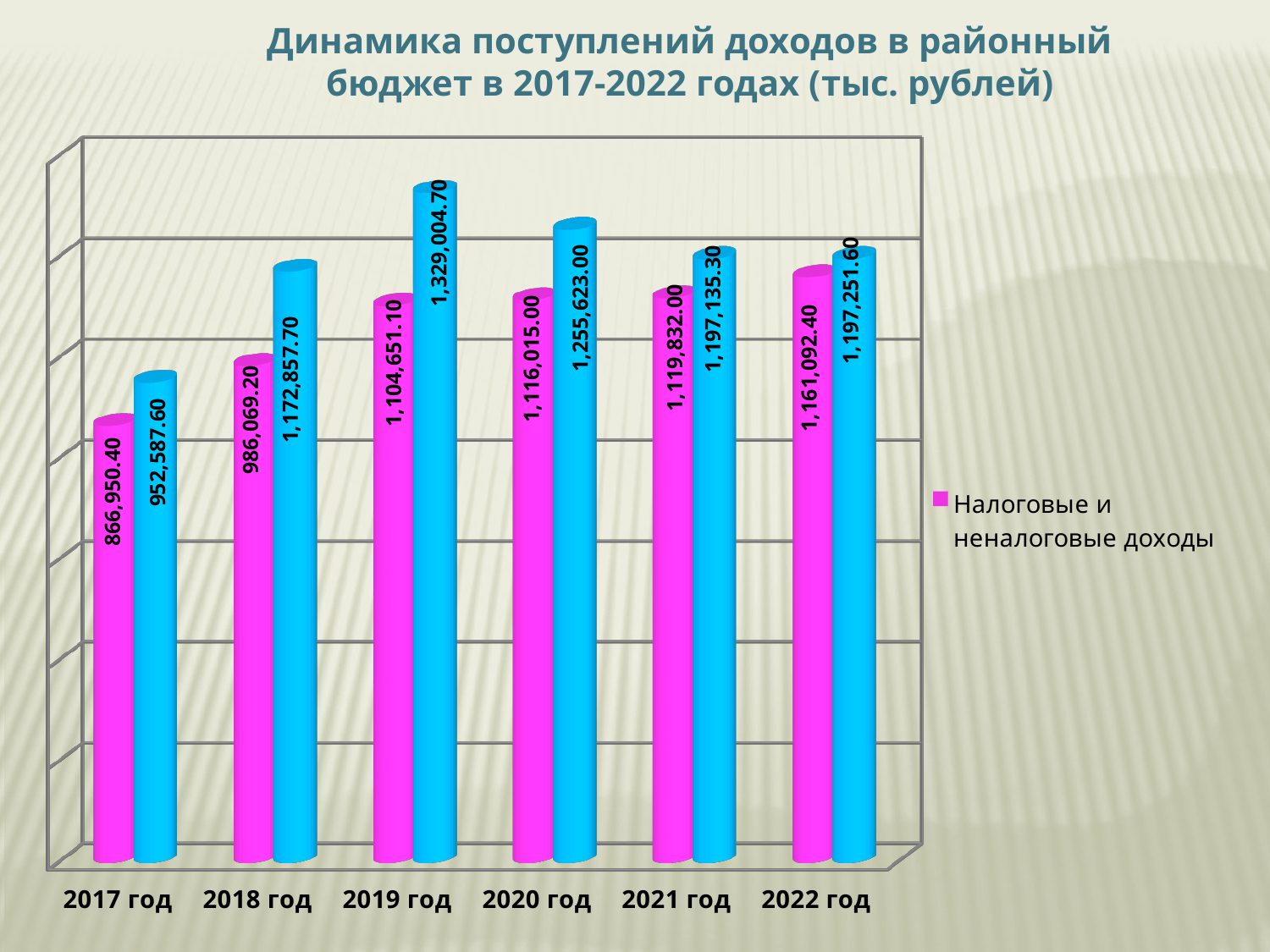
How many years are shown on the x axis? 6 What is the value of the blue bar for 2019 год? 1,329,004.70 What is the value of the 'Налоговые и неналоговые доходы' bar for 2022 год? 1,161,092.40 By how much did the 'Налоговые и неналоговые доходы' value in 2022 год exceed the value in 2017 год? 294,142.00 In which year is the blue bar the highest? 2019 год What is the difference between the blue bar and the 'Налоговые и неналоговые доходы' bar in 2019 год? 224,353.60 What is the value of the blue bar for 2021 год? 1,197,135.30 Do the 'Налоговые и неналоговые доходы' values rise or fall from 2017 год to 2022 год? Rise What kind of chart is shown on the slide? Bar chart In which year is the 'Налоговые и неналоговые доходы' bar the lowest? 2017 год Which is larger: the blue bar for 2018 год or the blue bar for 2020 год? 2020 год What is the value of the 'Налоговые и неналоговые доходы' bar for 2017 год? 866,950.40